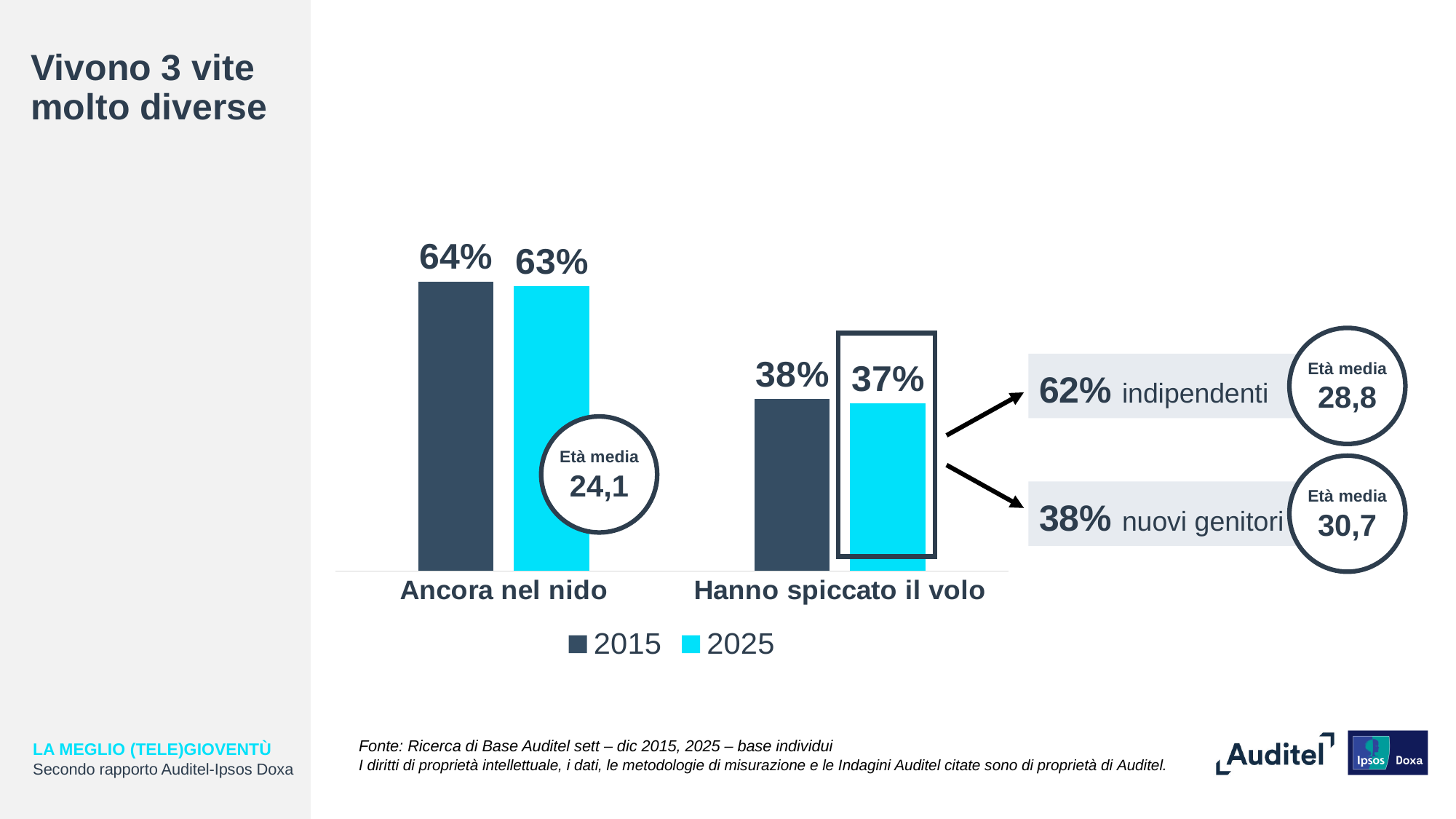
Which category has the lowest value in 2015? Hanno spiccato il volo What kind of chart is shown? Bar chart Which is larger: 'Ancora nel nido' in 2025 or 'Hanno spiccato il volo' in 2025? Ancora nel nido in 2025 What is the value for 'Ancora nel nido' in 2015? 64% How many categories are shown on the x axis? 2 Which category has the highest value in 2025? Ancora nel nido What is the value for 'Hanno spiccato il volo' in 2015? 38% What is the difference between the 2015 and 2025 values for 'Ancora nel nido'? 1% How many series does the legend list? 2 What is the difference between 'Ancora nel nido' and 'Hanno spiccato il volo' in 2015? 26% What is the value for 'Hanno spiccato il volo' in 2025? 37% What is the value for 'Ancora nel nido' in 2025? 63%